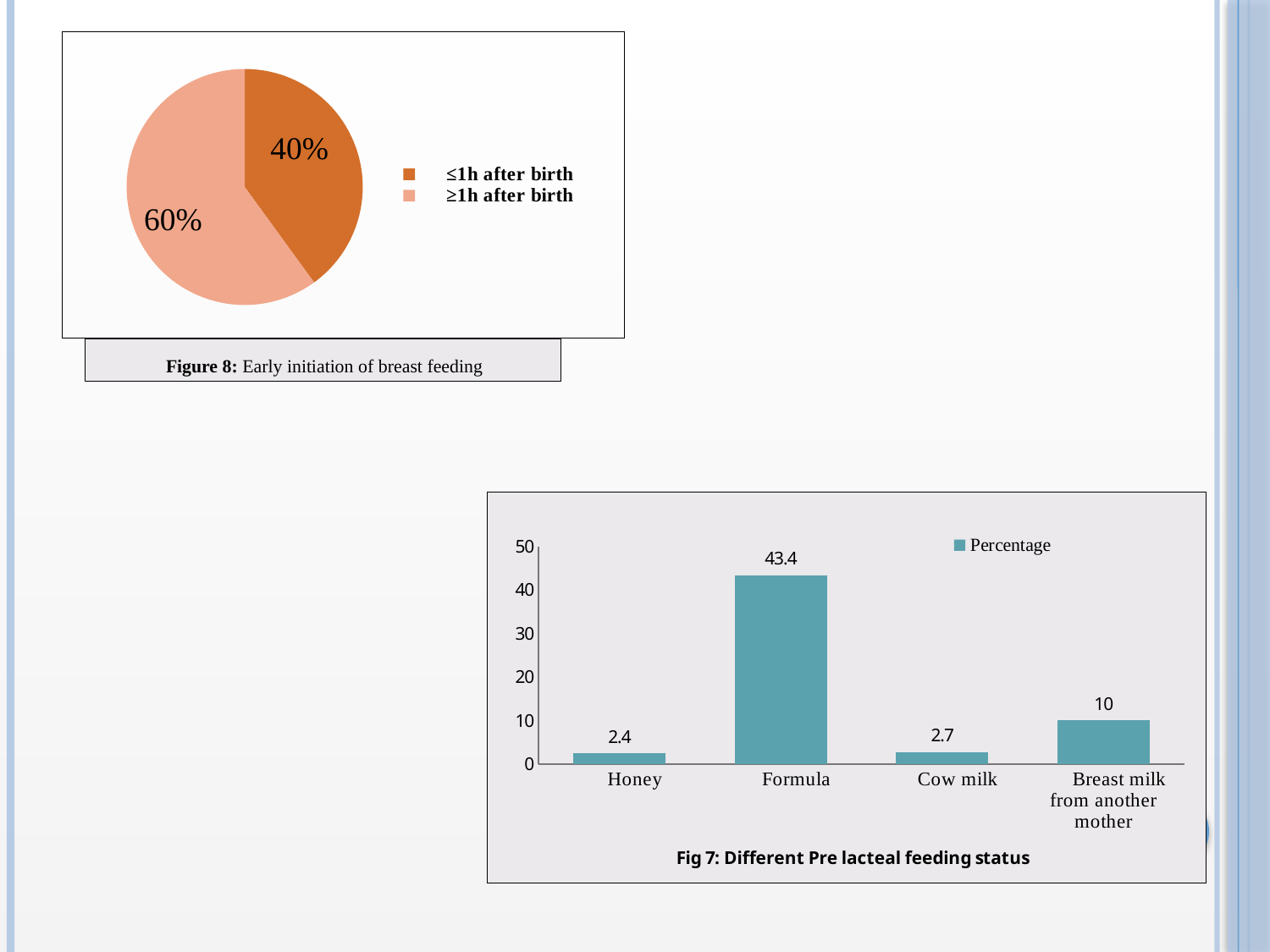
In Fig 7 (Different Pre lacteal feeding status), which category has the highest value? Formula In the Figure 8 pie chart, which category has the larger slice, ≤1h after birth or ≥1h after birth? ≥1h after birth What kind of chart is Fig 7 (Different Pre lacteal feeding status)? Bar chart How many categories are shown on the x axis of Fig 7 (Different Pre lacteal feeding status)? 4 In Fig 7 (Different Pre lacteal feeding status), which category has the lowest value? Honey How many slices does the Figure 8 pie chart have? 2 In the Figure 8 pie chart (Early initiation of breast feeding), what share is labelled for ≤1h after birth? 40% In Fig 7 (Different Pre lacteal feeding status), what is the value for Formula? 43.4 In Fig 7, what is the difference between the values for Formula and Breast milk from another mother? 33.4 In Fig 7 (Different Pre lacteal feeding status), what is the value for Honey? 2.4 In the Figure 8 pie chart (Early initiation of breast feeding), what share is labelled for ≥1h after birth? 60% What kind of chart is Figure 8 (Early initiation of breast feeding)? Pie chart